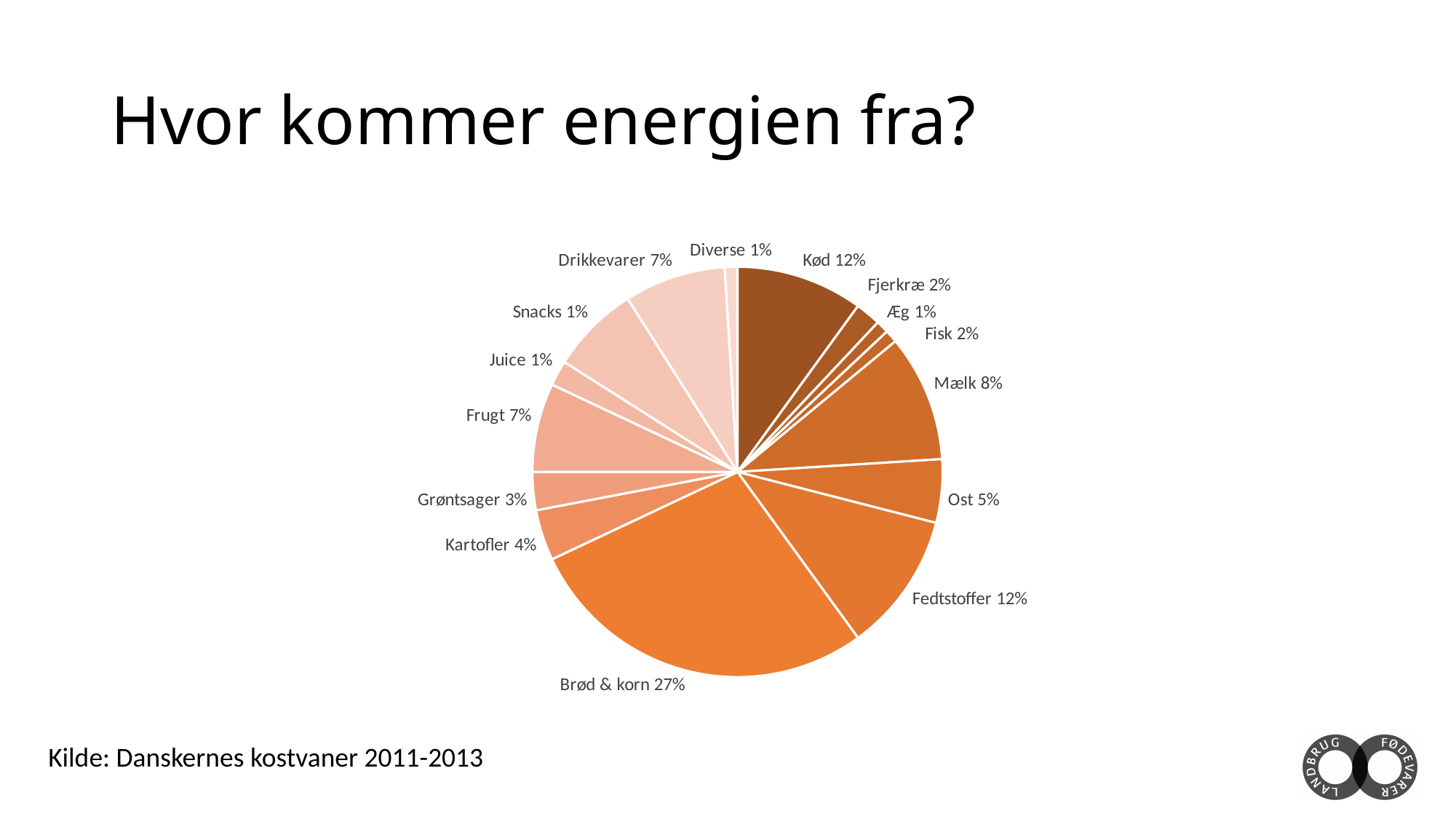
Which category has the largest slice of the pie? Brød & korn What is the title of the slide containing the chart? Hvor kommer energien fra? What is the value for Grøntsager? 3% What share of energy comes from Brød & korn? 27% What kind of chart is shown on the slide? Pie chart Which is larger, Frugt or Kartofler? Frugt What is the difference between the values for Brød & korn and Fedtstoffer? 15% How many categories are shown in the pie chart? 15 What is the difference between the values for Kød and Ost? 7% Which is larger, Mælk or Drikkevarer? Mælk What is the value for Mælk? 8% What is the value for Fedtstoffer? 12%